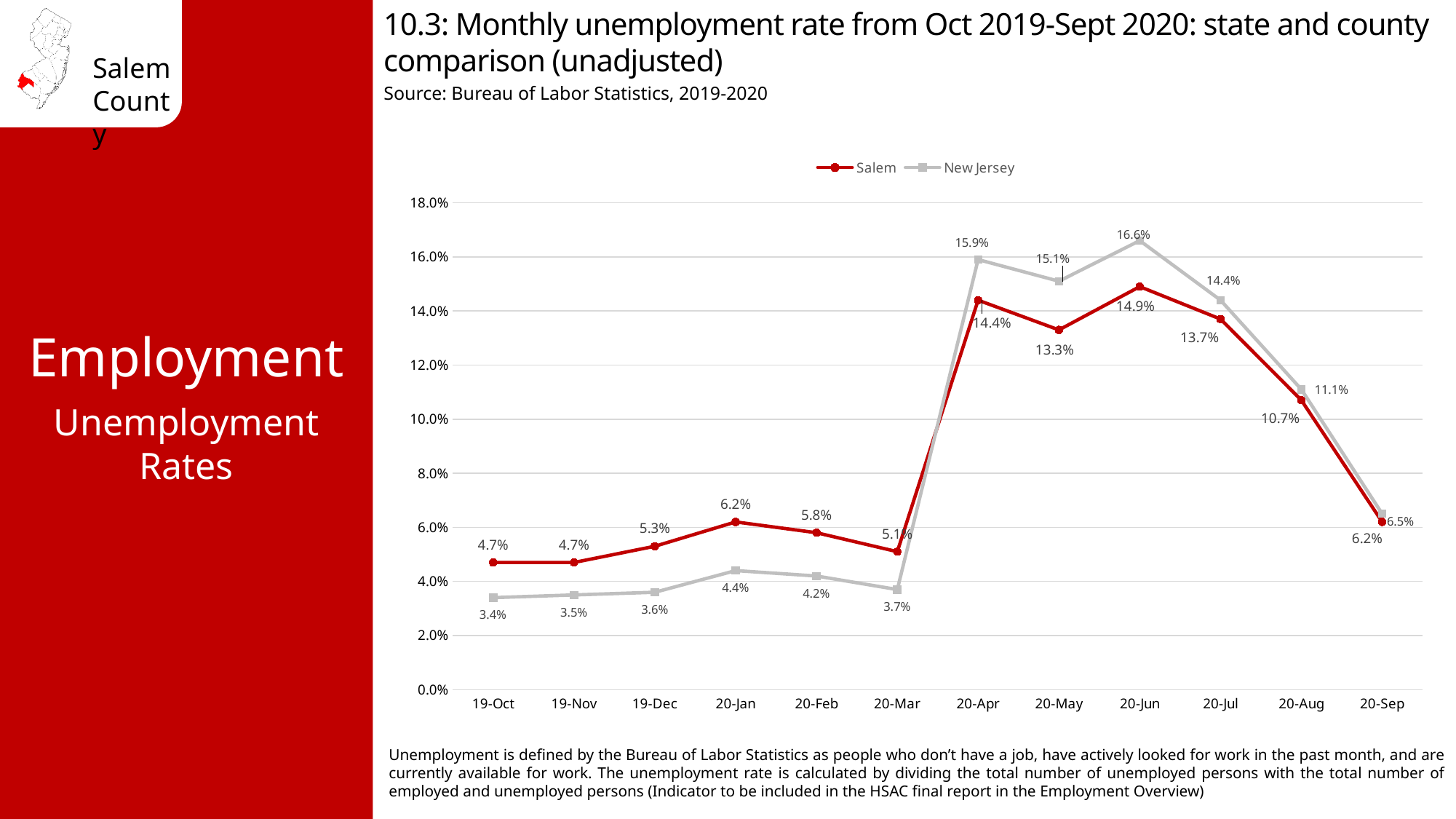
In which month does the New Jersey series reach its highest value? 20-Jun What kind of chart is shown on the slide? Line chart Which series has the higher value in 20-May, Salem or New Jersey? New Jersey How many series does the legend list? 2 Which series has the higher value in 19-Dec, Salem or New Jersey? Salem What is the New Jersey unemployment rate for 20-Jun? 16.6% How many months are shown on the x axis? 12 Does the Salem series rise or fall from 20-Jun to 20-Sep? Fall What is the Salem unemployment rate for 20-Jan? 6.2% What is the Salem unemployment rate for 20-Aug? 10.7% What is the difference between the New Jersey and Salem unemployment rates in 20-Apr? 1.5% In which month does the New Jersey series have its lowest value? 19-Oct